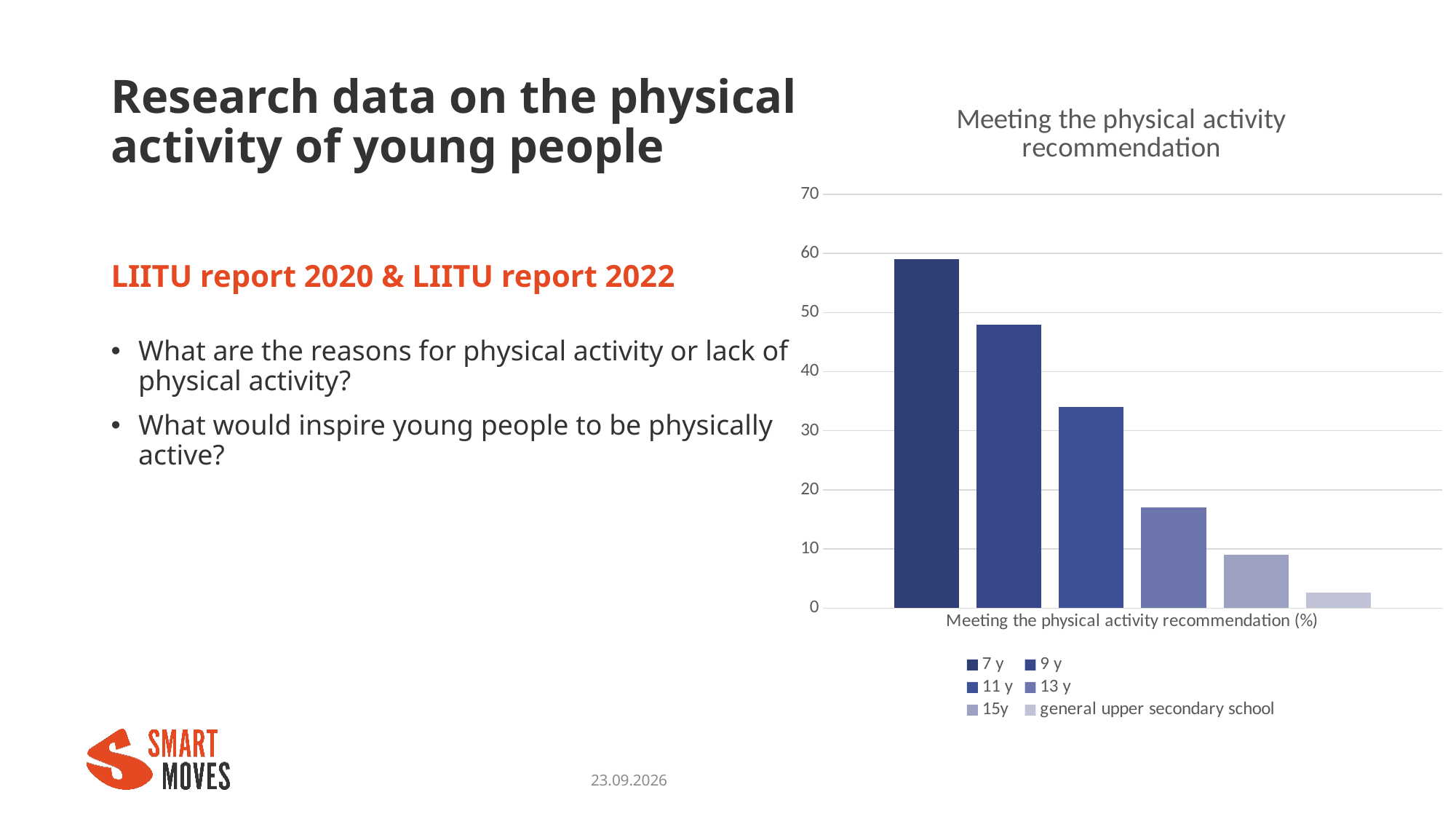
Which is larger, the value for 9 y or the value for 11 y? 9 y What is the title of the chart? Meeting the physical activity recommendation Which is larger, the value for 13 y or the value for 15y? 13 y Is the value for 13 y greater or less than 20? less How many series does the legend of the chart list? 6 Which series has the lowest value in the chart? general upper secondary school Which series has the highest value in the chart? 7 y Do the bar values rise or fall from the 7 y series to the general upper secondary school series? fall What kind of chart is shown on the slide? bar chart Is the value for 11 y greater or less than 40? less Is the value for 7 y greater or less than 50? greater